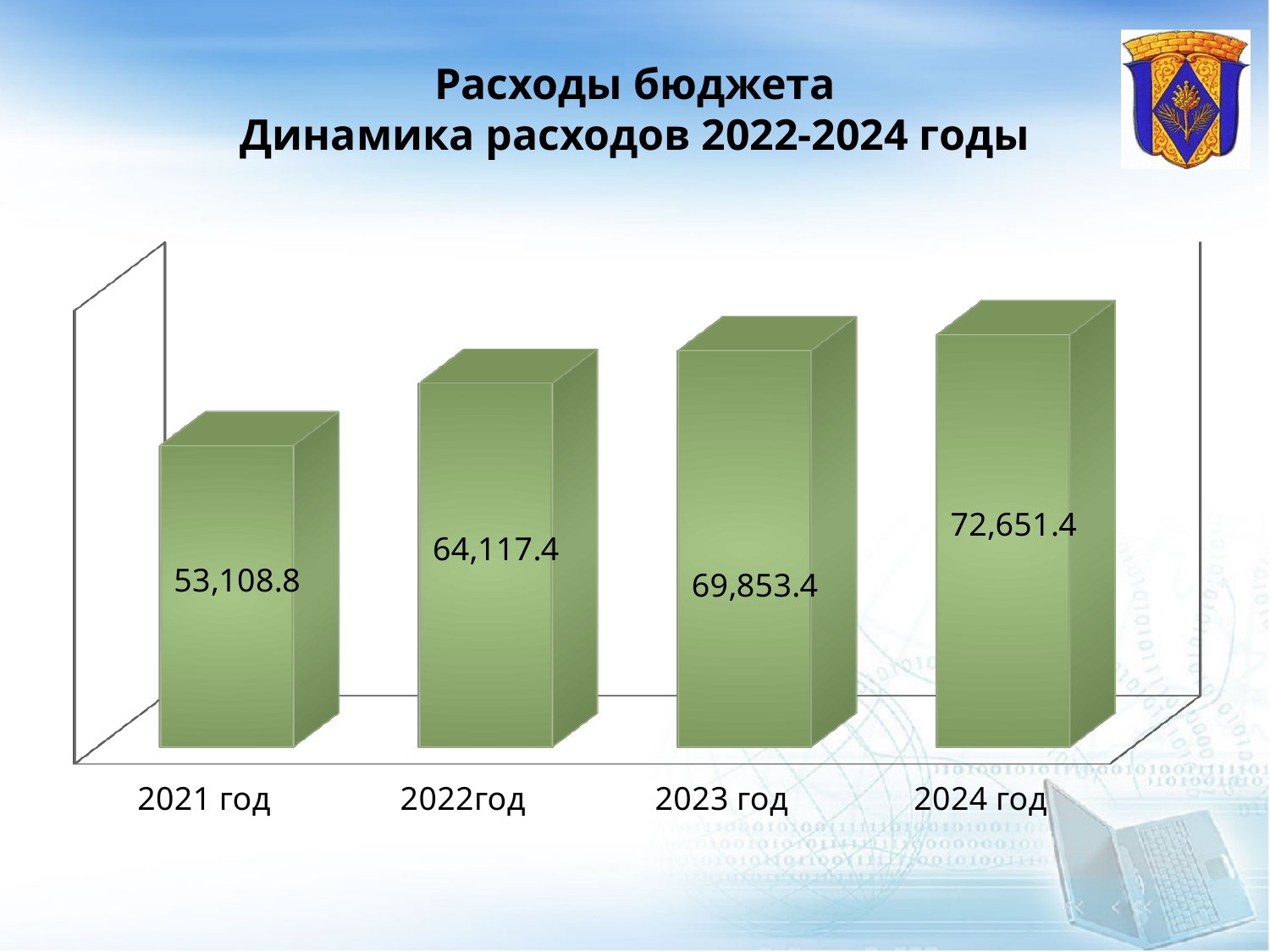
Do the values rise or fall from 2021 год to 2024 год? Rise How many bars are shown in the chart? 4 What is the value shown for 2024 год? 72,651.4 Which year has the highest value? 2024 год What kind of chart is shown on the slide? Bar chart What is the value shown for 2022год? 64,117.4 What is the difference between the values for 2022год and 2021 год? 11,008.6 Which is larger, the value for 2023 год or the value for 2022год? 2023 год What is the value shown for 2023 год? 69,853.4 What is the difference between the values for 2024 год and 2023 год? 2,798.0 What is the value shown for 2021 год? 53,108.8 Which year has the lowest value? 2021 год